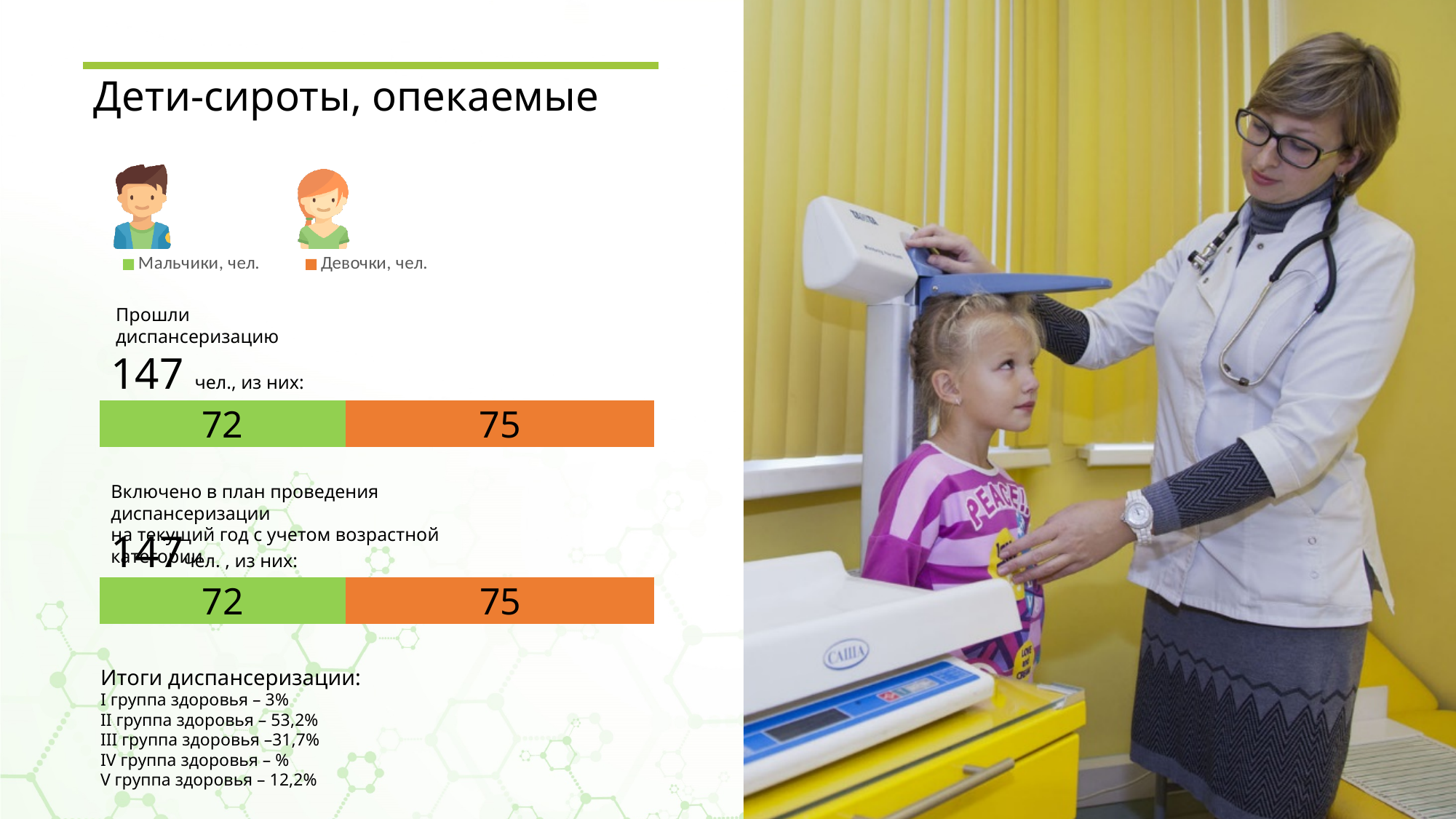
What colour represents Мальчики, чел. in the legend? Green In the lower chart (Включено в план проведения диспансеризации), what is the value for Девочки, чел.? 75 In the upper chart (Прошли диспансеризацию), which series has the larger value, Мальчики or Девочки? Девочки In the lower chart (Включено в план проведения диспансеризации), what is the value for Мальчики, чел.? 72 In the lower chart (Включено в план проведения диспансеризации), what is the total of the stacked bar? 147 In the upper chart (Прошли диспансеризацию), what is the difference between the values for Девочки and Мальчики? 3 In the upper chart (Прошли диспансеризацию), what is the value for Девочки, чел.? 75 What colour represents Девочки, чел. in the legend? Orange How many series does the legend list? 2 In the upper chart (Прошли диспансеризацию), what is the total of the stacked bar? 147 In the upper chart (Прошли диспансеризацию), what is the value for Мальчики, чел.? 72 What kind of chart is the upper chart (Прошли диспансеризацию)? Stacked bar chart